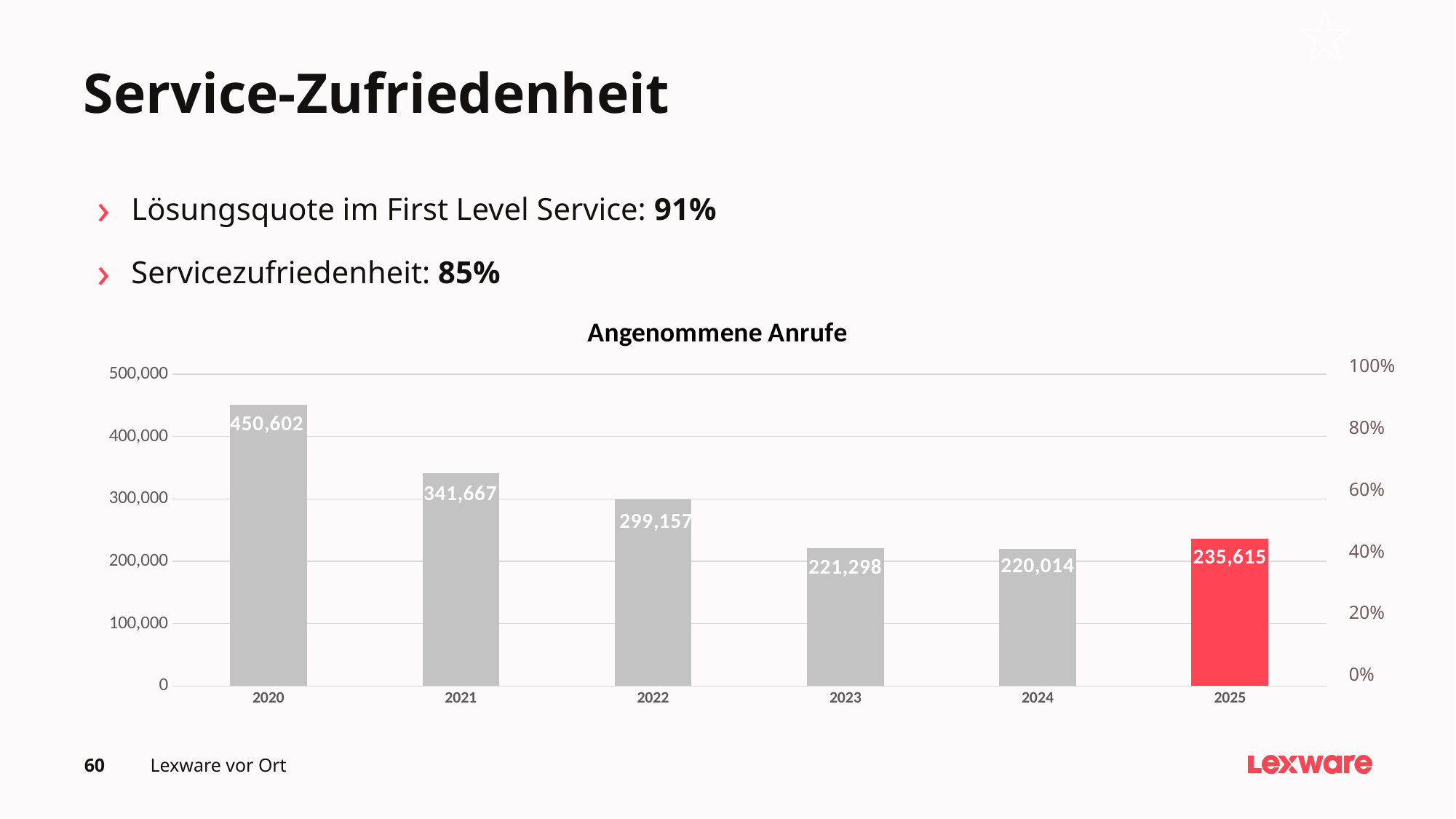
Which year has the highest number of Angenommene Anrufe? 2020 Do the values in the Angenommene Anrufe chart rise or fall from 2020 to 2024? fall What is the value for 2025 in the Angenommene Anrufe chart? 235,615 Which is larger in the Angenommene Anrufe chart, the value for 2021 or the value for 2022? 2021 What is the difference between the 2025 and 2024 values in the Angenommene Anrufe chart? 15,601 What is the value for 2020 in the Angenommene Anrufe chart? 450,602 Is the value for 2021 in the Angenommene Anrufe chart greater or less than 300,000? greater What is the value for 2022 in the Angenommene Anrufe chart? 299,157 What kind of chart is the Angenommene Anrufe chart? bar chart What is the difference between the 2020 and 2021 values in the Angenommene Anrufe chart? 108,935 Which year's bar is shown in red in the Angenommene Anrufe chart? 2025 How many years are shown on the x axis of the Angenommene Anrufe chart? 6